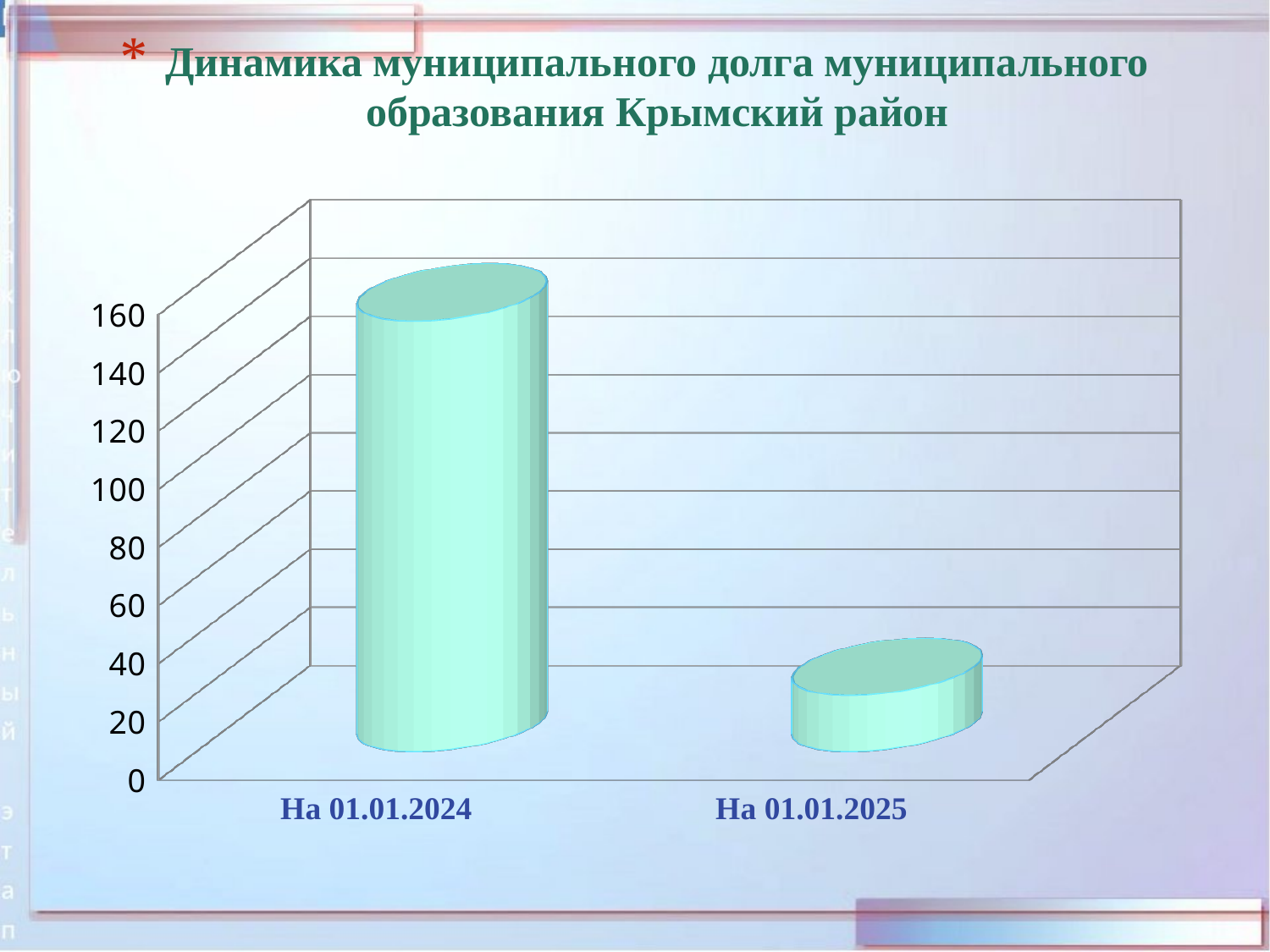
Is the value for На 01.01.2025 greater or less than 60? less Is the value for На 01.01.2025 greater or less than 100? less How many categories are shown on the x axis of the chart? 2 Do the values rise or fall from На 01.01.2024 to На 01.01.2025? fall What is the title of the slide containing the chart? Динамика муниципального долга муниципального образования Крымский район What kind of chart is shown on the slide? bar chart Which category has the highest value in the chart? На 01.01.2024 What is the highest tick value shown on the vertical axis of the chart? 160 Which is larger, the value for На 01.01.2024 or the value for На 01.01.2025? На 01.01.2024 Is the value for На 01.01.2024 greater or less than 100? greater Which category has the lowest value in the chart? На 01.01.2025